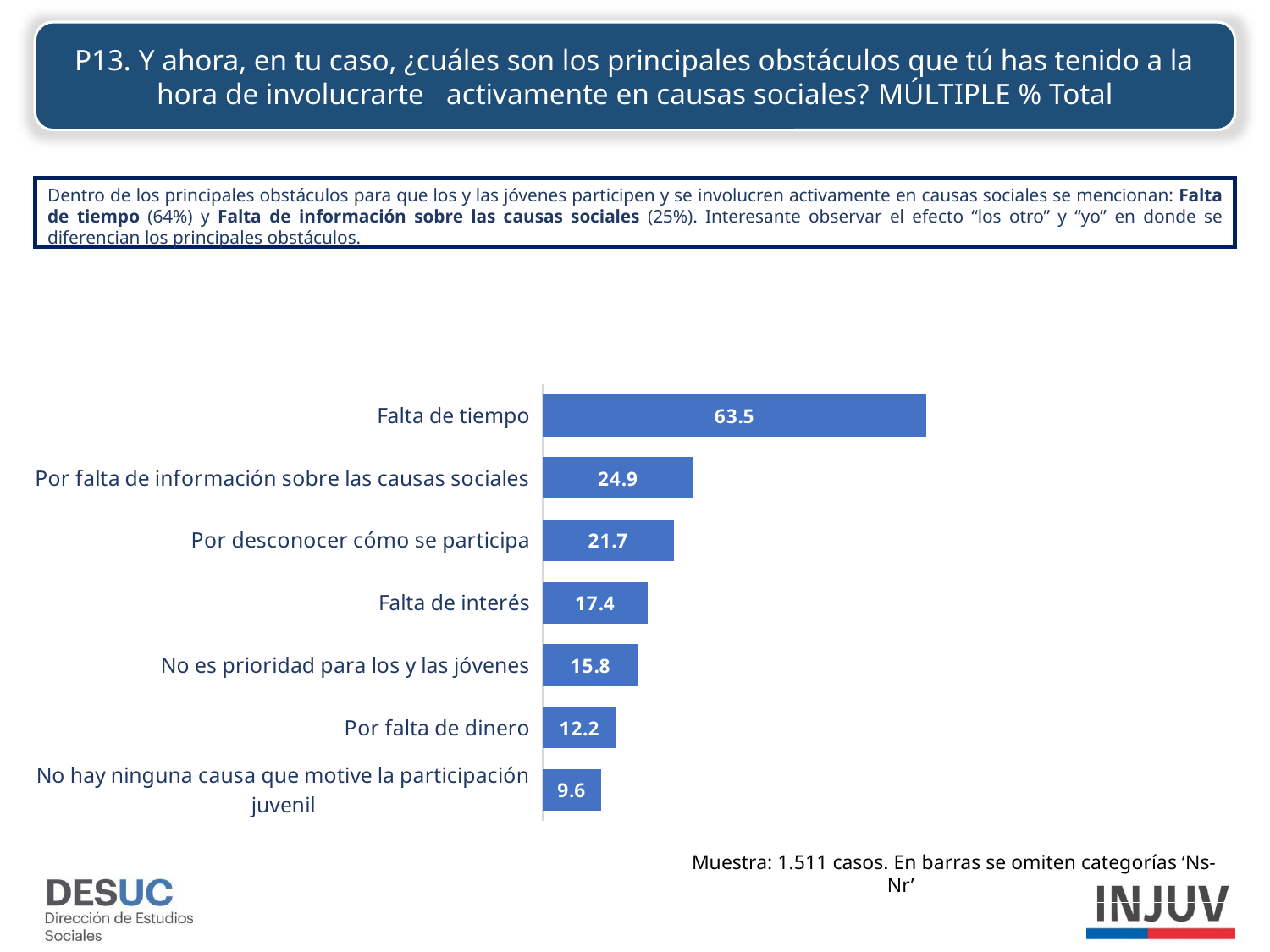
What is the difference between the values for "Falta de tiempo" and "Por falta de información sobre las causas sociales"? 38.6 What is the value for "Por desconocer cómo se participa"? 21.7 Which is larger: the value for "Por desconocer cómo se participa" or the value for "Falta de interés"? Por desconocer cómo se participa What is the value for "Por falta de dinero"? 12.2 What is the value for "Falta de tiempo"? 63.5 What kind of chart is shown on the slide? Bar chart What is the value for "Por falta de información sobre las causas sociales"? 24.9 Which category has the highest value? Falta de tiempo What is the difference between the values for "Falta de interés" and "No es prioridad para los y las jóvenes"? 1.6 Which category has the lowest value? No hay ninguna causa que motive la participación juvenil How many categories are shown in the chart? 7 What sample size is stated below the chart? 1.511 casos